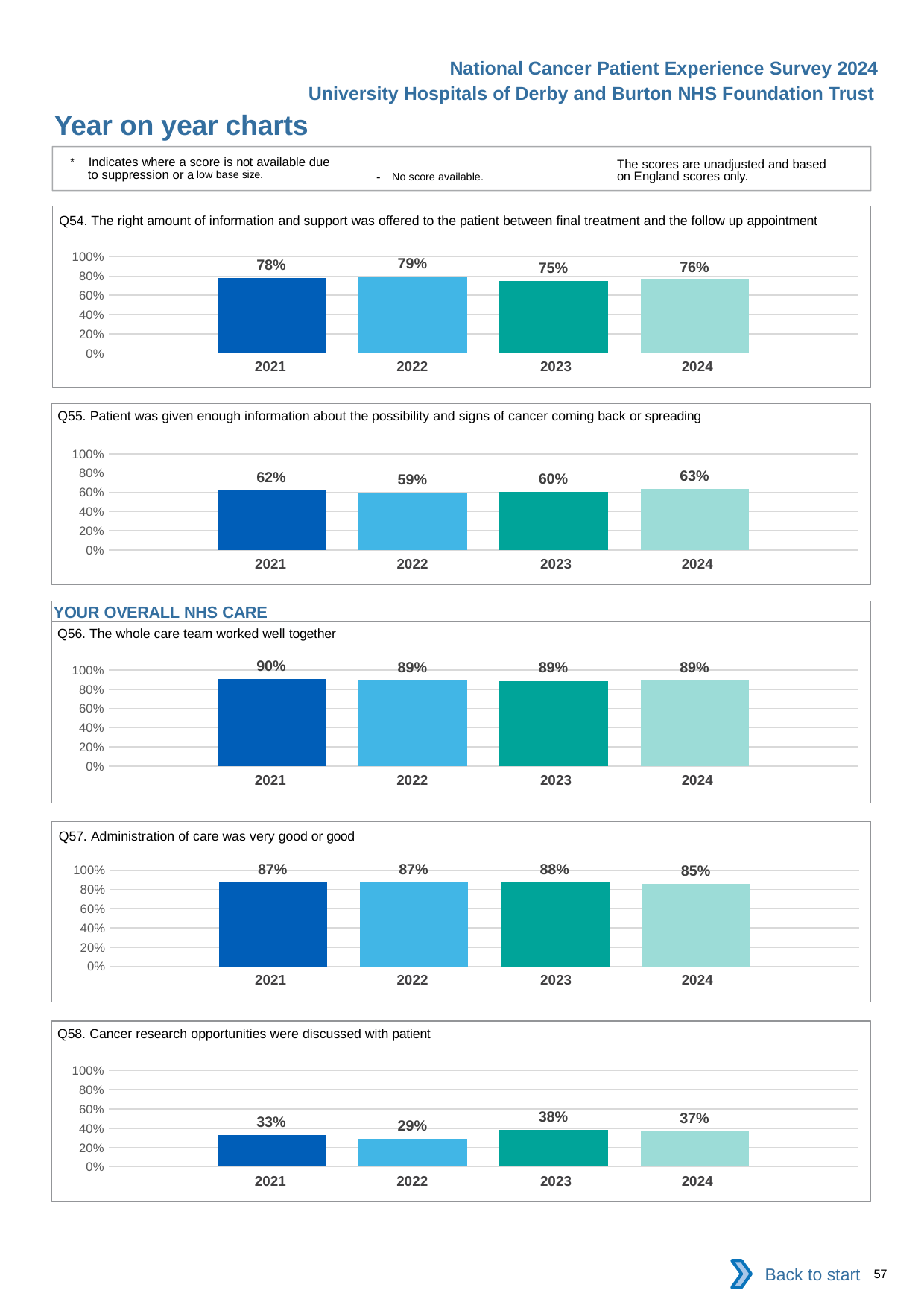
In the Q58 chart, what is the difference between the 2023 value and the 2022 value? 9% What kind of chart is the Q57 chart? bar chart In the Q55 chart, which year has the lowest value? 2022 In the Q58 chart, what is the value for 2024? 37% How many years are shown in the Q56 chart? 4 In the Q58 chart, is the value for 2021 greater or less than 40%? less How many charts are shown on the slide? 5 In the Q57 chart, which is larger, the value for 2023 or the value for 2024? 2023 In the Q56 chart, what is the value for 2021? 90% In the Q55 chart, which year has the highest value? 2024 In the Q54 chart, what is the difference between the 2022 value and the 2023 value? 4% In the Q54 chart, what is the value for 2022? 79%